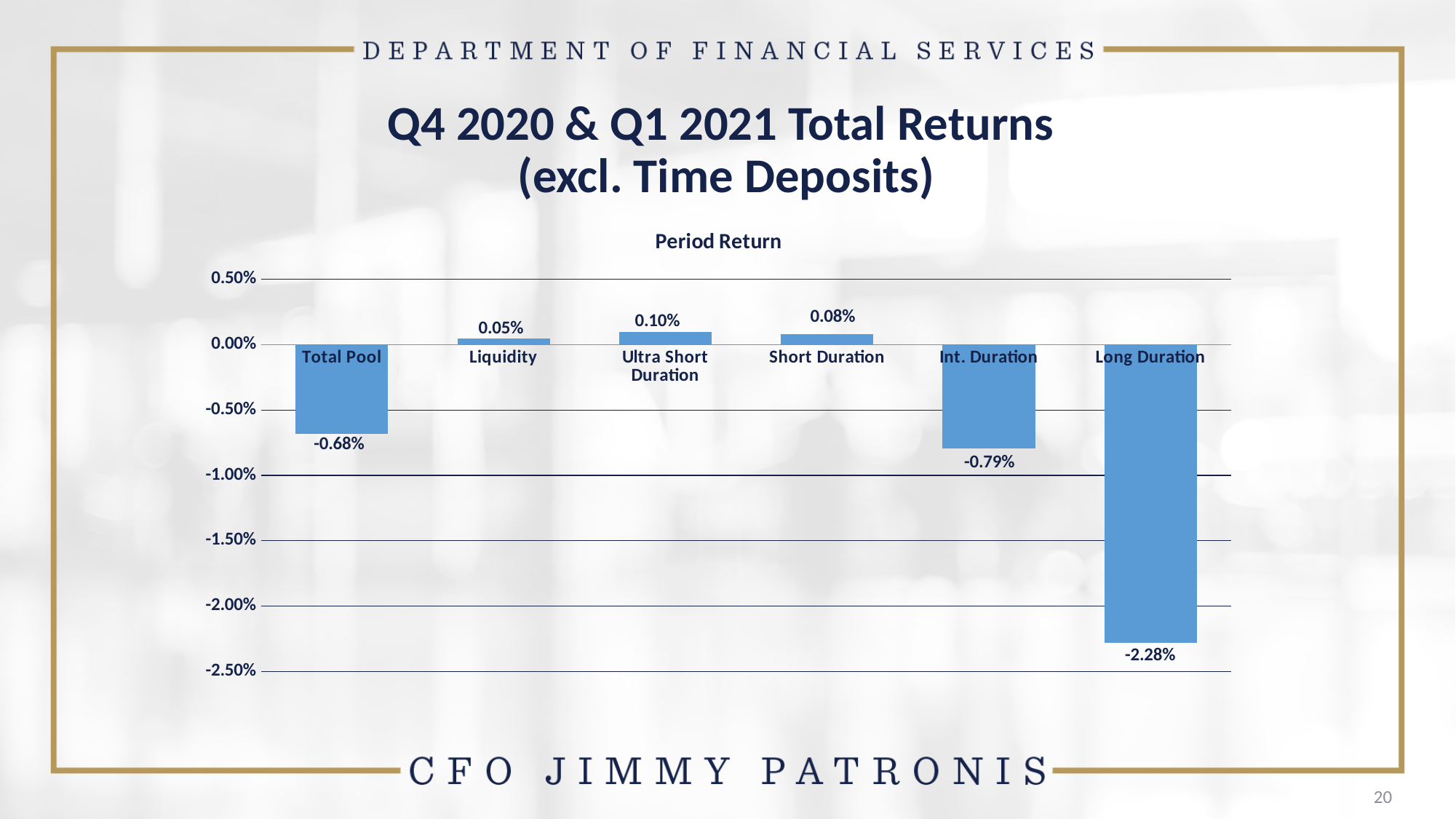
What is the period return for Long Duration? -2.28% What is the period return for Liquidity? 0.05% Which has a higher period return, Short Duration or Liquidity? Short Duration What kind of chart is shown on the slide? Bar chart Is the period return for Long Duration greater or less than -2.00%? less How many categories are shown in the chart? 6 What is the difference between the period returns of Int. Duration and Total Pool? 0.11% What is the period return for Ultra Short Duration? 0.10% What is the period return for Total Pool? -0.68% What is the title of the chart? Period Return Which category has the highest period return? Ultra Short Duration Which category has the lowest period return? Long Duration